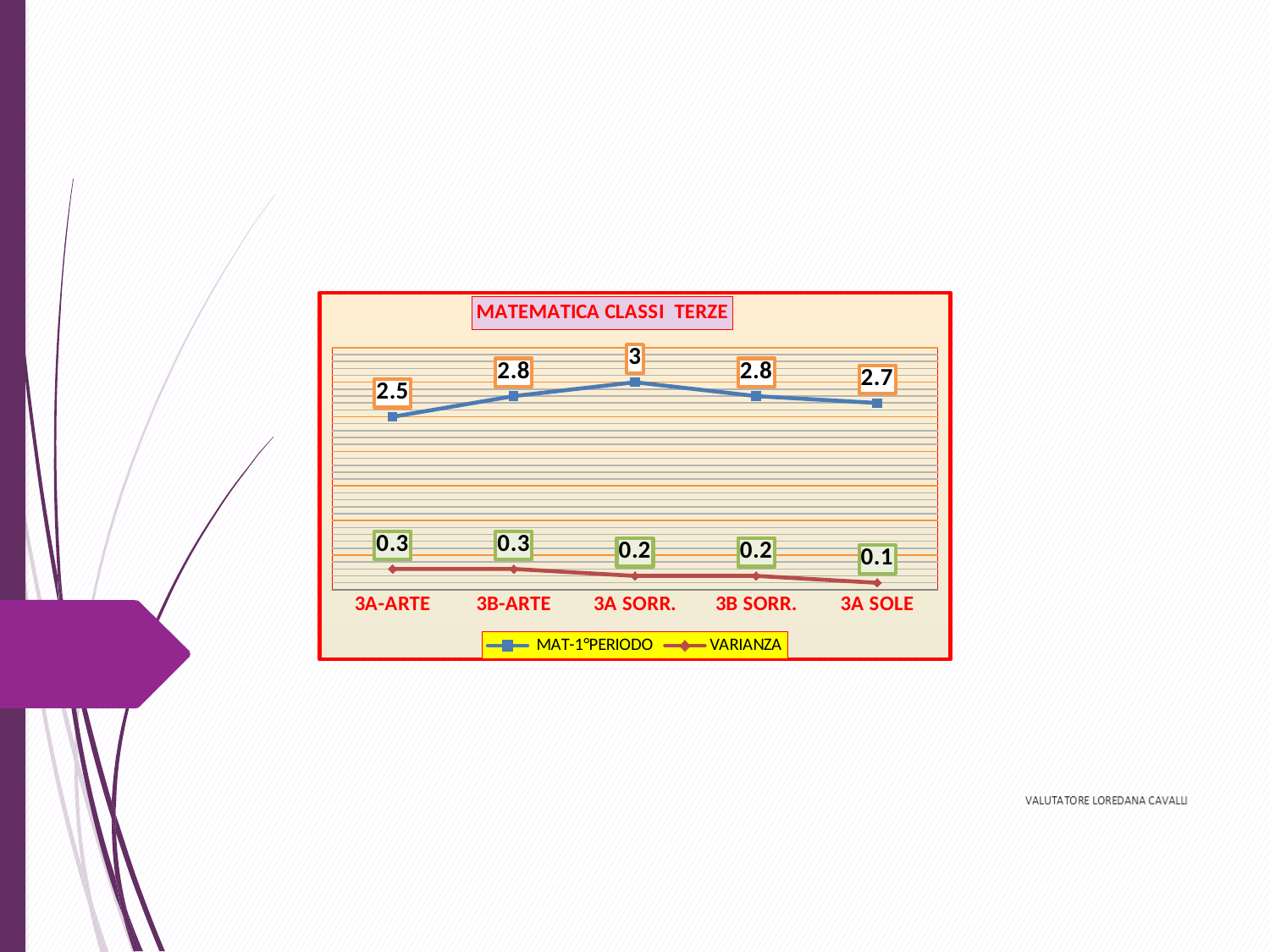
What is the MAT-1°PERIODO value for 3A SORR.? 3 Which category has the highest MAT-1°PERIODO value? 3A SORR. What is the difference between the MAT-1°PERIODO values for 3A SORR. and 3A-ARTE? 0.5 What kind of chart is this? line chart Which is larger, the MAT-1°PERIODO value for 3B-ARTE or for 3A SOLE? 3B-ARTE What is the title of the chart? MATEMATICA CLASSI TERZE What is the VARIANZA value for 3A SOLE? 0.1 What is the MAT-1°PERIODO value for 3A-ARTE? 2.5 Which category has the lowest MAT-1°PERIODO value? 3A-ARTE How many series does the legend list? 2 How many categories are shown on the x axis? 5 Which category has the lowest VARIANZA value? 3A SOLE